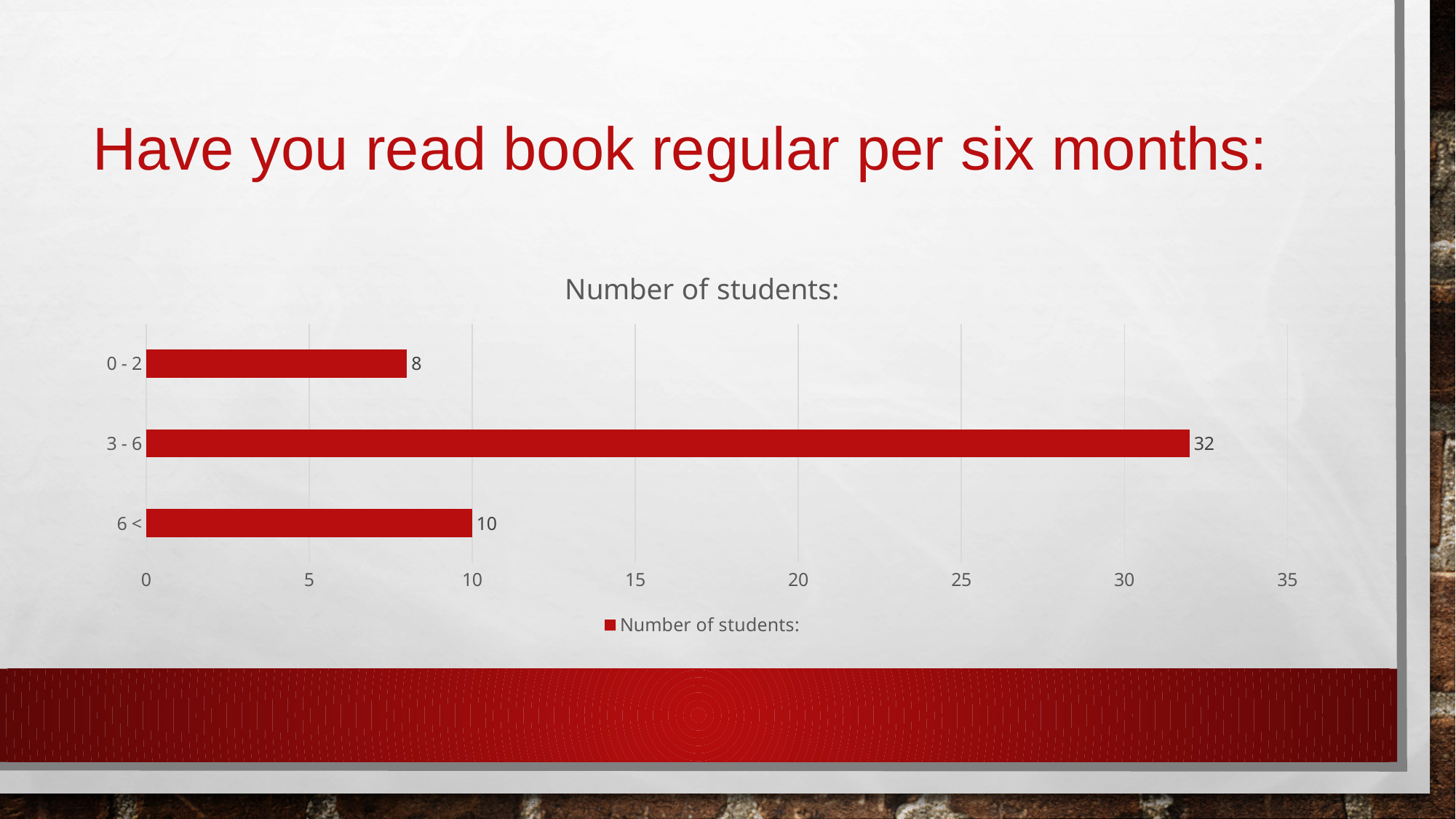
Which category has the lowest number of students? 0 - 2 What is the number of students for the "0 - 2" category? 8 How many series does the legend list? 1 Is the value for "3 - 6" greater or less than 30? greater What is the title of the chart? Number of students: What is the difference in number of students between the "3 - 6" and "6 <" categories? 22 What kind of chart is shown on the slide? Bar chart Which category has more students, "0 - 2" or "6 <"? 6 < What is the number of students for the "3 - 6" category? 32 Which category has the highest number of students? 3 - 6 How many categories are shown in the chart? 3 What is the number of students for the "6 <" category? 10